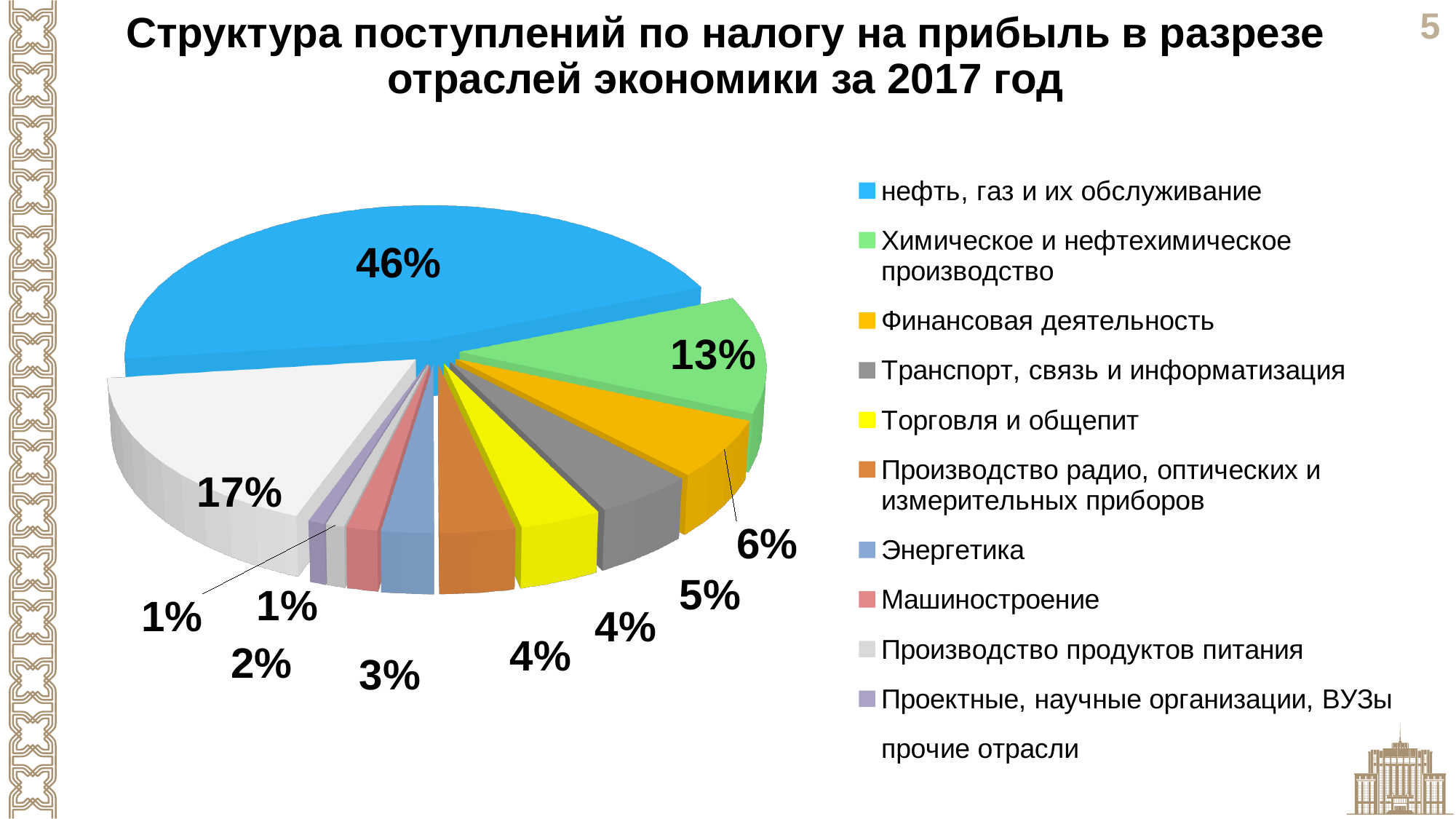
What share is shown for "Финансовая деятельность"? 6% What kind of chart is shown on the slide? pie chart What share is shown for "Энергетика"? 3% Which has the larger share: "Финансовая деятельность" or "Транспорт, связь и информатизация"? Финансовая деятельность What share of profit tax receipts comes from "нефть, газ и их обслуживание"? 46% Which sector has the largest share of the pie? нефть, газ и их обслуживание What share is shown for "Химическое и нефтехимическое производство"? 13% How many sectors (slices) does the pie chart show? 11 What share is shown for "Машиностроение"? 2% By how many percentage points does the share of "нефть, газ и их обслуживание" exceed that of "Химическое и нефтехимическое производство"? 33 percentage points What share is shown for "Транспорт, связь и информатизация"? 5% What share is shown for "прочие отрасли"? 17%